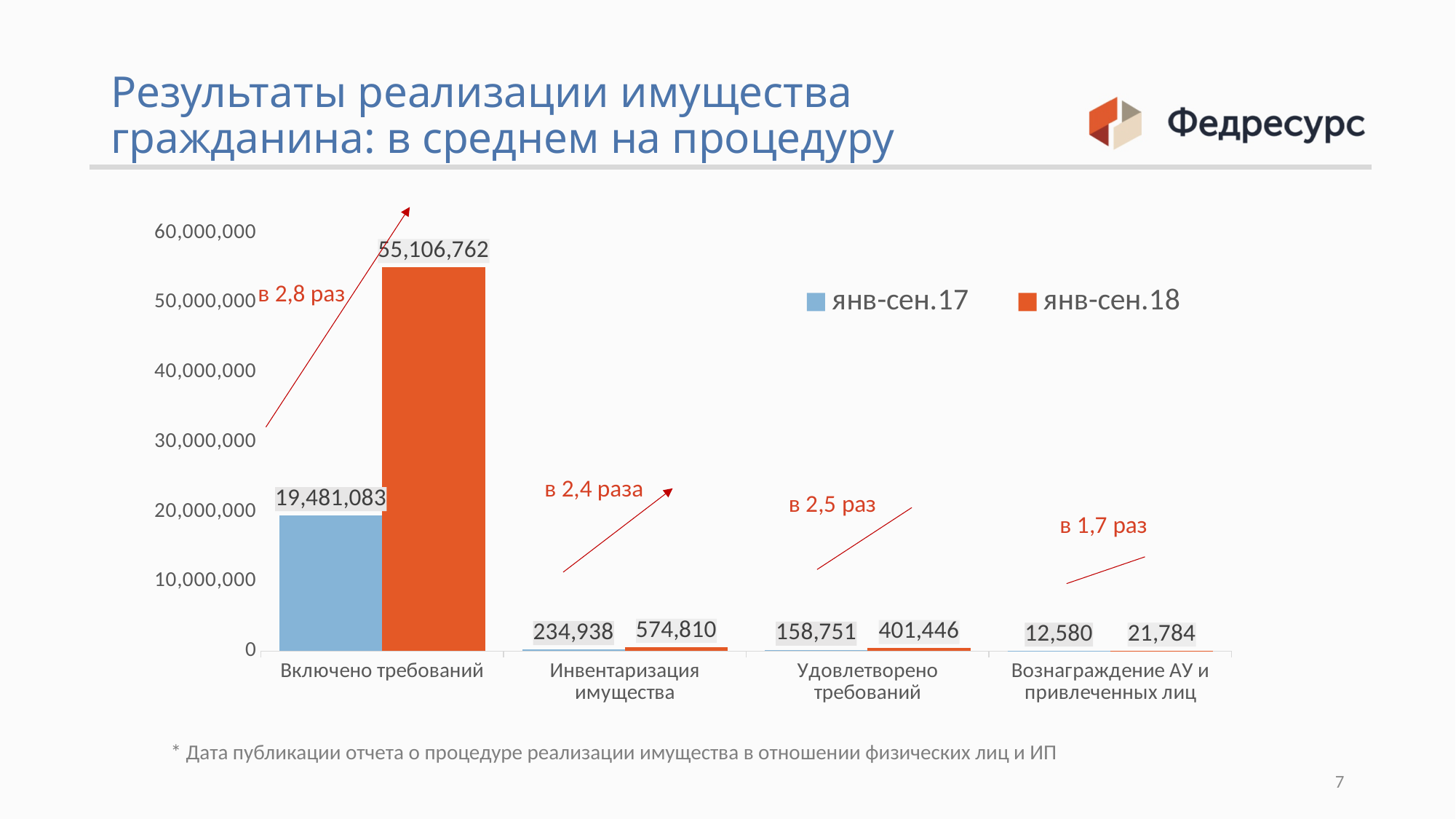
How many series does the legend list? 2 What is the value for «Включено требований» in the янв-сен.17 series? 19,481,083 Which category has the lowest value in the янв-сен.17 series? Вознаграждение АУ и привлеченных лиц What is the value for «Удовлетворено требований» in the янв-сен.17 series? 158,751 What kind of chart is shown on the slide? Bar chart What is the difference between the янв-сен.18 and янв-сен.17 values for «Удовлетворено требований»? 242,695 What is the value for «Включено требований» in the янв-сен.18 series? 55,106,762 What is the difference between the янв-сен.18 and янв-сен.17 values for «Включено требований»? 35,625,679 Which category has the highest value in the янв-сен.18 series? Включено требований Which is larger for «Инвентаризация имущества»: the янв-сен.17 value or the янв-сен.18 value? янв-сен.18 What is the value for «Инвентаризация имущества» in the янв-сен.18 series? 574,810 What is the value for «Вознаграждение АУ и привлеченных лиц» in the янв-сен.18 series? 21,784